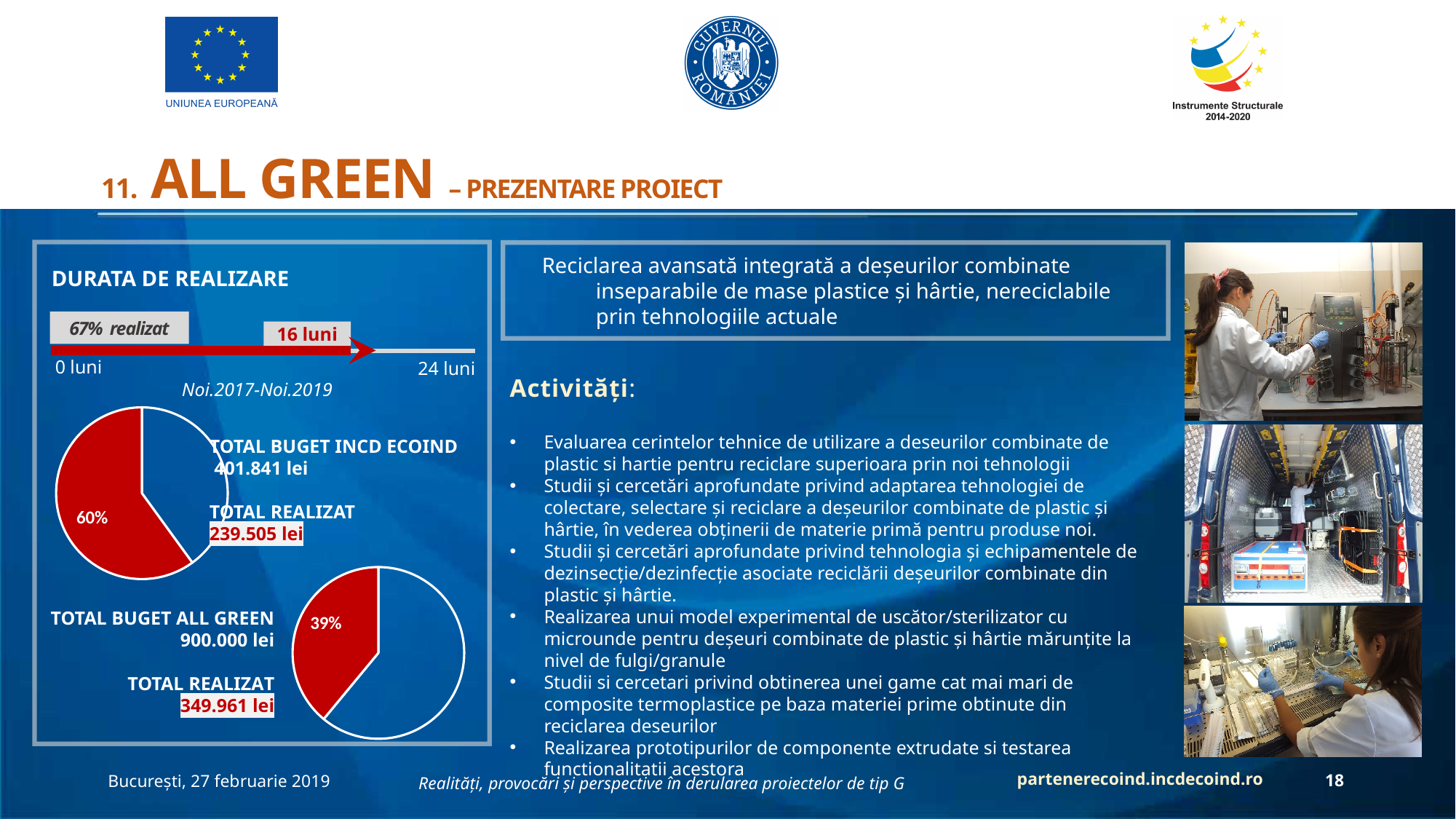
In the lower pie chart (TOTAL BUGET ALL GREEN), what percentage is shown on the red slice? 39% What is the value of TOTAL BUGET ALL GREEN shown next to the lower pie chart? 900.000 lei In the DURATA DE REALIZARE timeline, what percentage is marked as realizat? 67% In the DURATA DE REALIZARE timeline, how many months does the red arrow mark out of the 24 luni total? 16 luni How many slices does each pie chart on the slide have? 2 What kind of chart is used to show the TOTAL BUGET INCD ECOIND versus TOTAL REALIZAT? pie chart Which pie chart has the larger red slice, the upper one (INCD ECOIND) or the lower one (ALL GREEN)? the upper one (INCD ECOIND) In the upper pie chart (TOTAL BUGET INCD ECOIND), what percentage is shown on the red slice? 60% What is the TOTAL REALIZAT value shown next to the upper pie chart (INCD ECOIND)? 239.505 lei What is the value of TOTAL BUGET INCD ECOIND shown next to the upper pie chart? 401.841 lei What is the TOTAL REALIZAT value shown next to the lower pie chart (ALL GREEN)? 349.961 lei How many pie charts are on the slide? 2